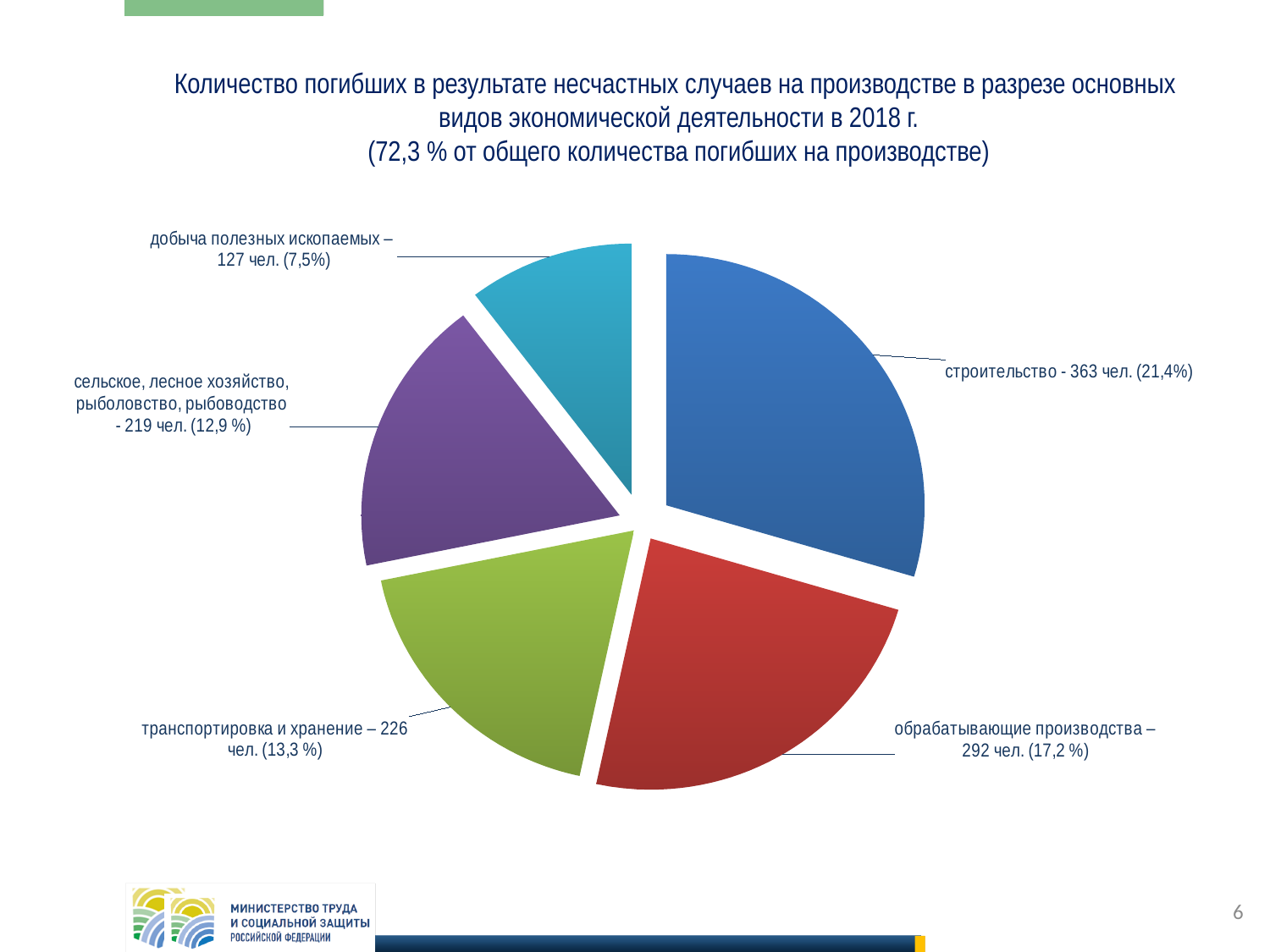
How many people died in строительство according to the chart? 363 чел. Which sector has the largest slice in the pie chart? строительство What colour is the slice for строительство? blue What is the difference in deaths between строительство and обрабатывающие производства? 71 What number of deaths is given for обрабатывающие производства? 292 чел. Which has more deaths: обрабатывающие производства or добыча полезных ископаемых? обрабатывающие производства What is the difference in deaths between транспортировка и хранение and сельское, лесное хозяйство, рыболовство, рыбоводство? 7 How many slices does the pie chart have? 5 What percentage is printed for добыча полезных ископаемых? 7,5% What number of deaths is shown for транспортировка и хранение? 226 чел. What kind of chart is shown on the slide? pie chart Which sector has the smallest slice in the pie chart? добыча полезных ископаемых